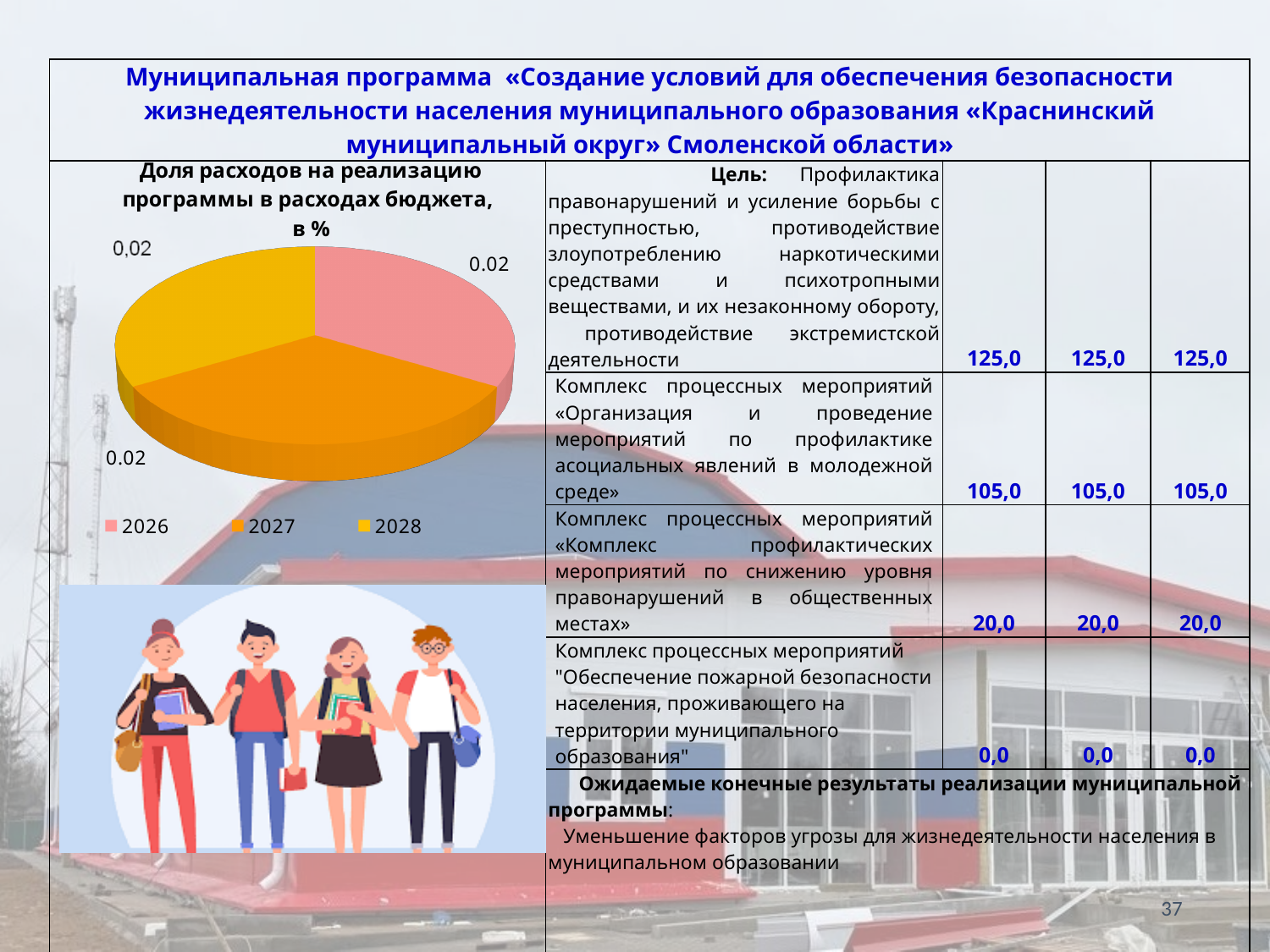
Which years are listed in the legend of the pie chart? 2026, 2027, 2028 What is the difference between the values for 2026 and 2027 in the pie chart? 0 How many slices does the pie chart have? 3 What value is labelled on the pie chart for 2027? 0.02 What value is labelled on the pie chart for 2028? 0,02 What kind of chart is shown on the slide? pie chart How many entries does the legend of the pie chart list? 3 What colour represents 2028 in the pie chart? yellow What value is labelled on the pie chart for 2026? 0.02